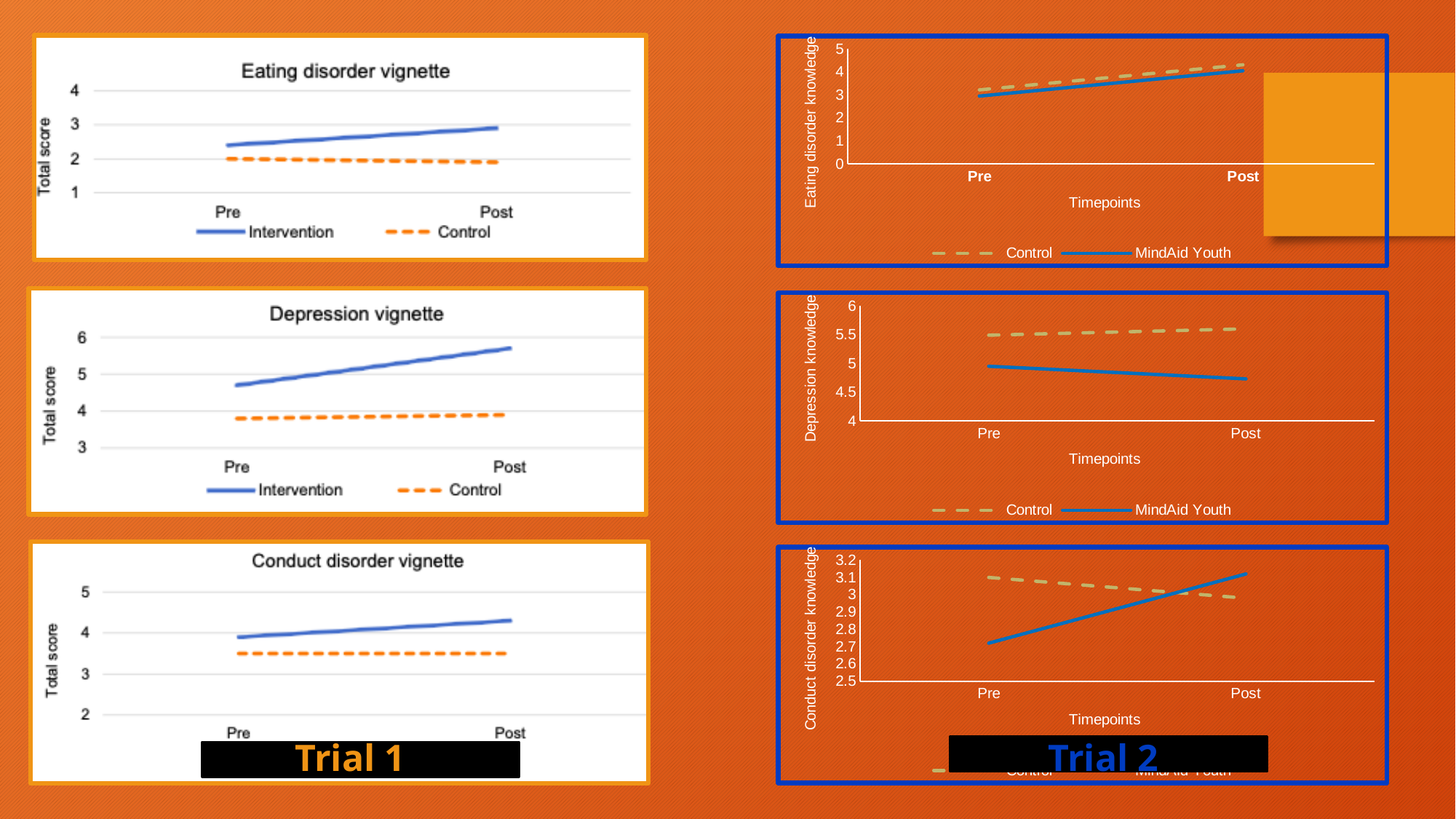
In the Trial 2 'Depression knowledge' chart, does the MindAid Youth line rise or fall from Pre to Post? falls In the Trial 2 'Eating disorder knowledge' chart, what are the two legend entries? Control and MindAid Youth In the 'Depression vignette' chart, is the Control value at Pre greater or less than 4? less In the Trial 2 'Conduct disorder knowledge' chart, which series has the higher value at Pre, Control or MindAid Youth? Control In the Trial 2 'Eating disorder knowledge' chart, how many timepoints are shown on the x axis? 2 In the Trial 2 'Depression knowledge' chart, is the Control value at Post greater or less than 5? greater In the 'Eating disorder vignette' chart, how many series does the legend list? 2 In the 'Conduct disorder vignette' chart, which series has the higher value at Post, Intervention or Control? Intervention In the 'Eating disorder vignette' chart, is the Intervention value at Pre greater or less than 3? less What kind of chart is the 'Eating disorder vignette' chart on the left of the slide? line chart In the 'Eating disorder vignette' chart, does the Intervention line rise or fall from Pre to Post? rises